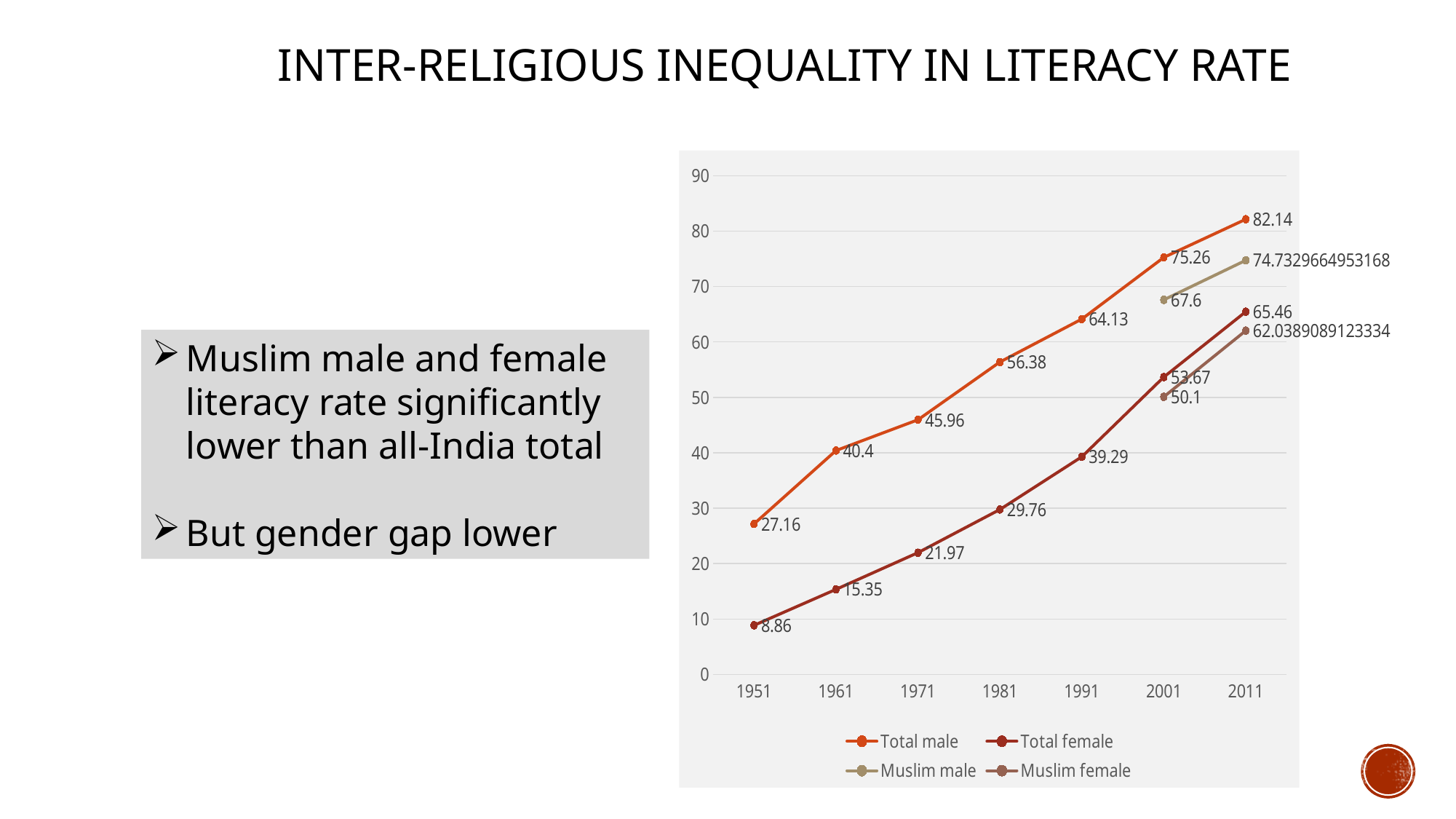
What is the Total male literacy rate in 1951? 27.16 What is the Muslim male literacy rate in 2001? 67.6 What is the Total female literacy rate in 2011? 65.46 Which is larger in 2001, the Total female literacy rate or the Muslim female literacy rate? Total female What is the difference between the Total male and Muslim male literacy rates in 2001? 7.66 What is the Muslim female literacy rate in 2001? 50.1 Does the Total female literacy rate rise or fall from 1951 to 2011? Rise In which year is the Total female literacy rate lowest? 1951 In which year is the Total male literacy rate highest? 2011 What kind of chart is shown on the slide? Line chart What is the difference between the Total male and Total female literacy rates in 2011? 16.68 How many series does the legend list? 4